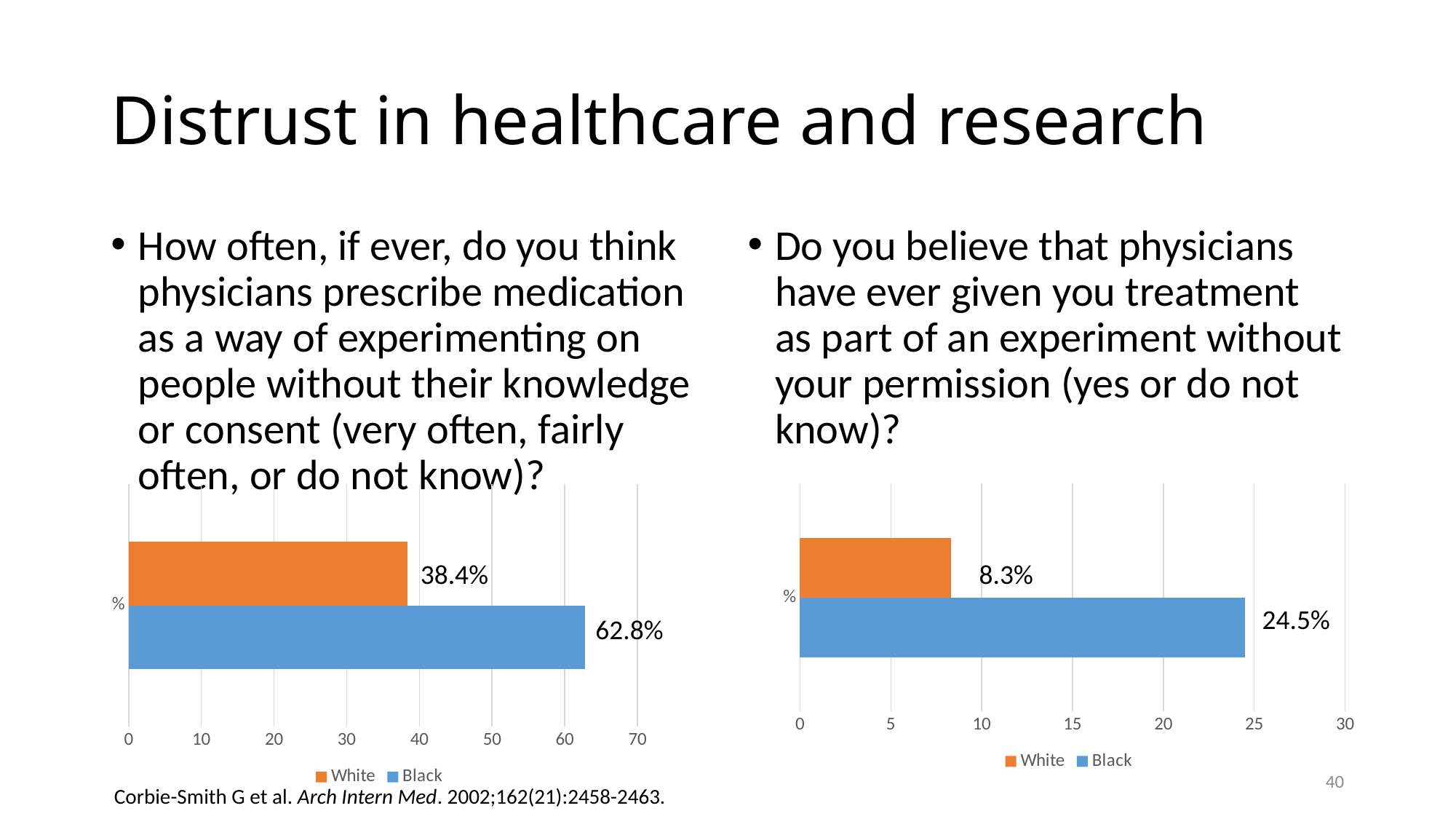
In the right chart, is the value for Black greater or less than 20? greater In the left chart, what is the difference between the Black and White values? 24.4% In the left chart, which series has the higher value? Black What kind of chart is the right chart? bar chart In the right chart, what is the value for White? 8.3% In the right chart, what is the value for Black? 24.5% How many series does the legend of the left chart list? 2 In the right chart, what is the difference between the Black and White values? 16.2% In the left chart, what is the value for Black? 62.8% In the left chart, which colour represents the White series? orange In the left chart, what is the value for White? 38.4% In the right chart, which series has the lower value? White